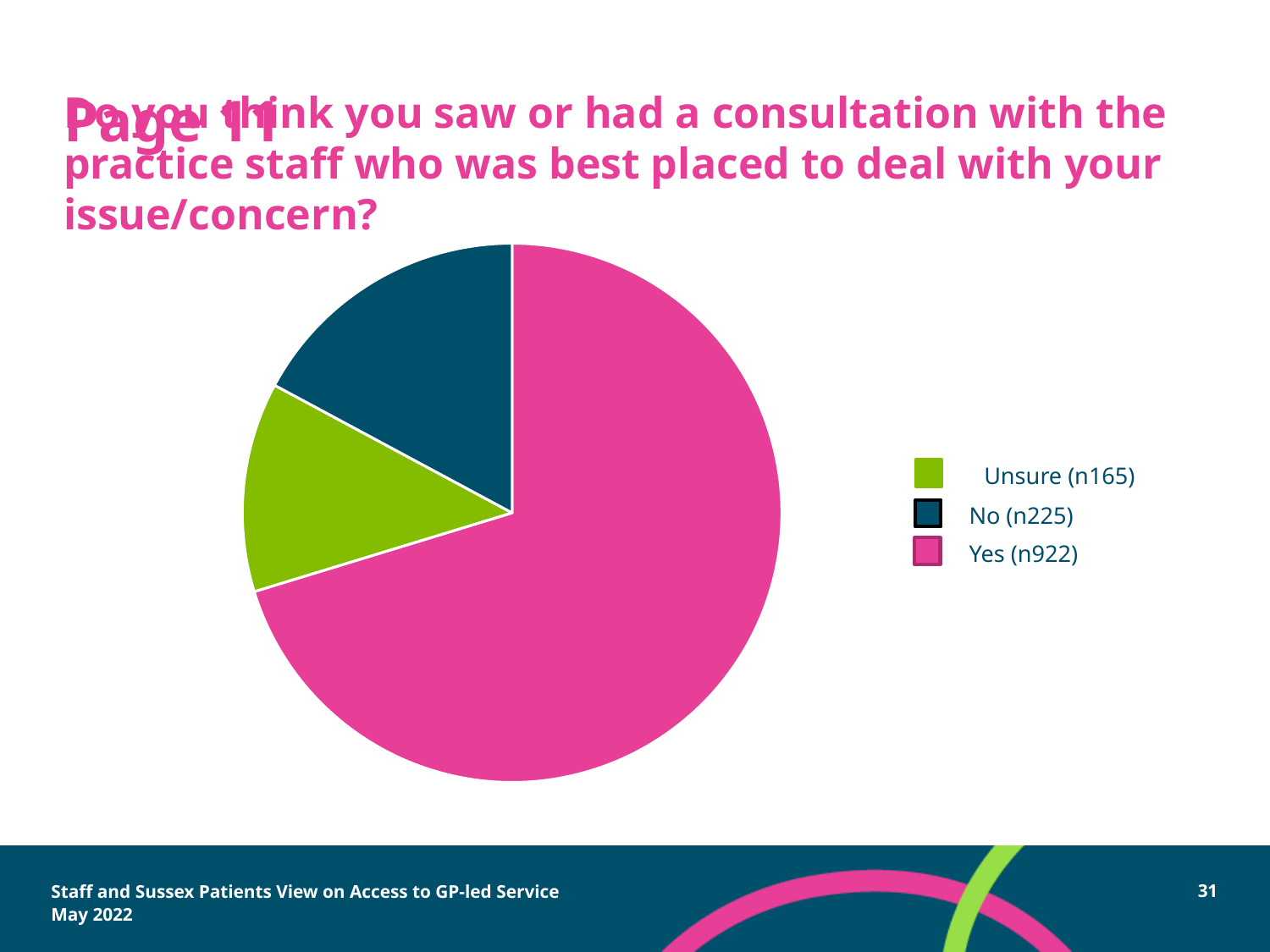
What is the count (n) for the 'No' category? 225 What colour is the 'Yes' slice of the pie chart? Pink What type of chart is shown on the slide? Pie chart What is the difference between the 'Yes' count and the 'No' count? 697 What is the difference between the 'No' count and the 'Unsure' count? 60 What is the count (n) for the 'Yes' category? 922 How many categories does the pie chart show? 3 How many entries does the legend list? 3 What is the count (n) for the 'Unsure' category? 165 Which is larger, the 'No' count or the 'Unsure' count? No Which category has the largest slice of the pie? Yes Which category has the smallest slice of the pie? Unsure